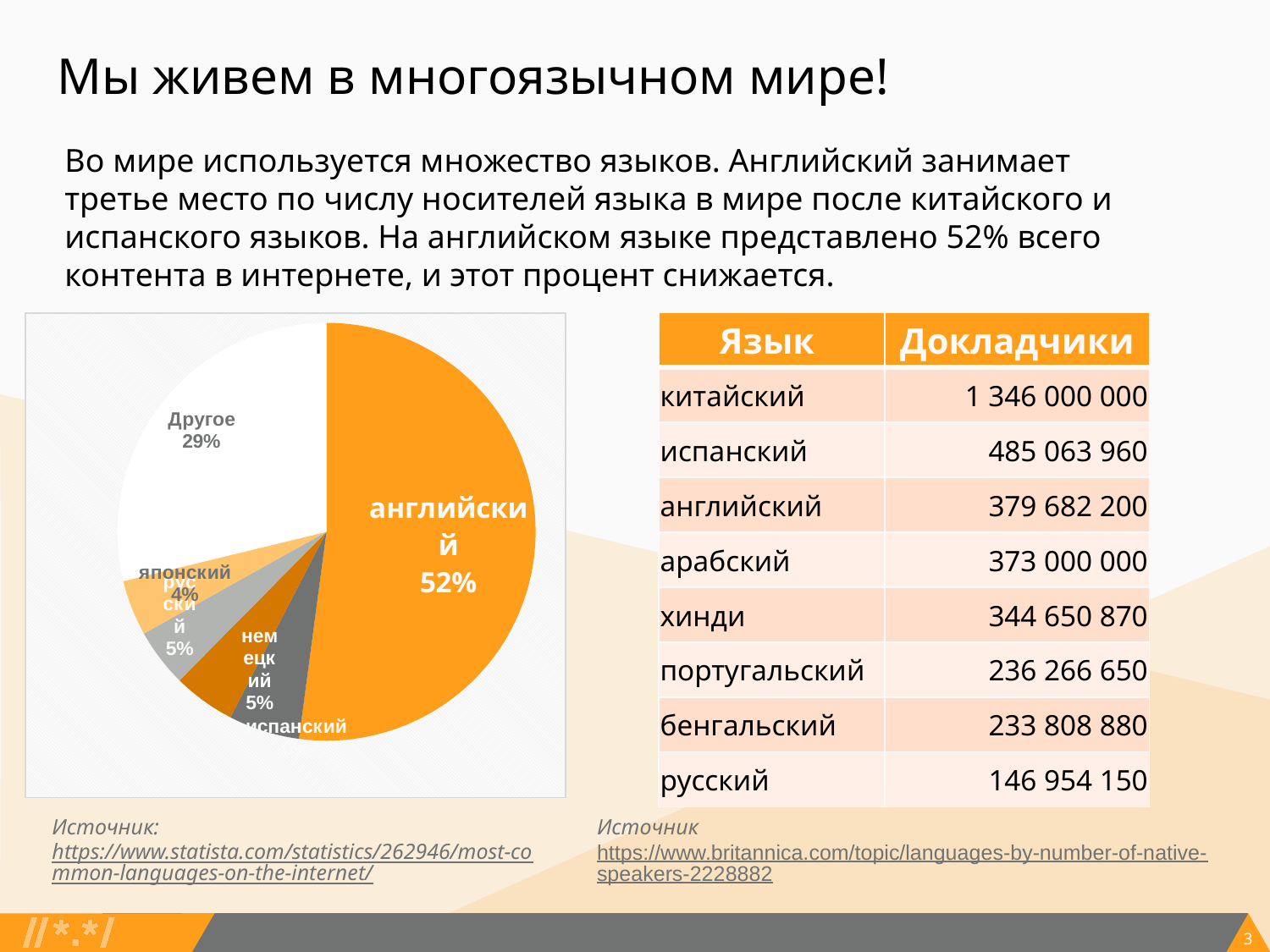
What colour is the английский slice in the pie chart? orange In the pie chart, what is the combined share of русский and немецкий? 10% In the pie chart, what share does Другое have? 29% In the pie chart, what share does русский have? 5% How many slices does the pie chart have? 6 In the pie chart, how many percentage points larger is английский than Другое? 23 What kind of chart is shown on the left of the slide? pie chart In the pie chart, what share does английский have? 52% In the pie chart, what share does немецкий have? 5% In the pie chart, which is larger: Другое or русский? Другое Which slice of the pie chart is the largest? английский In the pie chart, what share does японский have? 4%